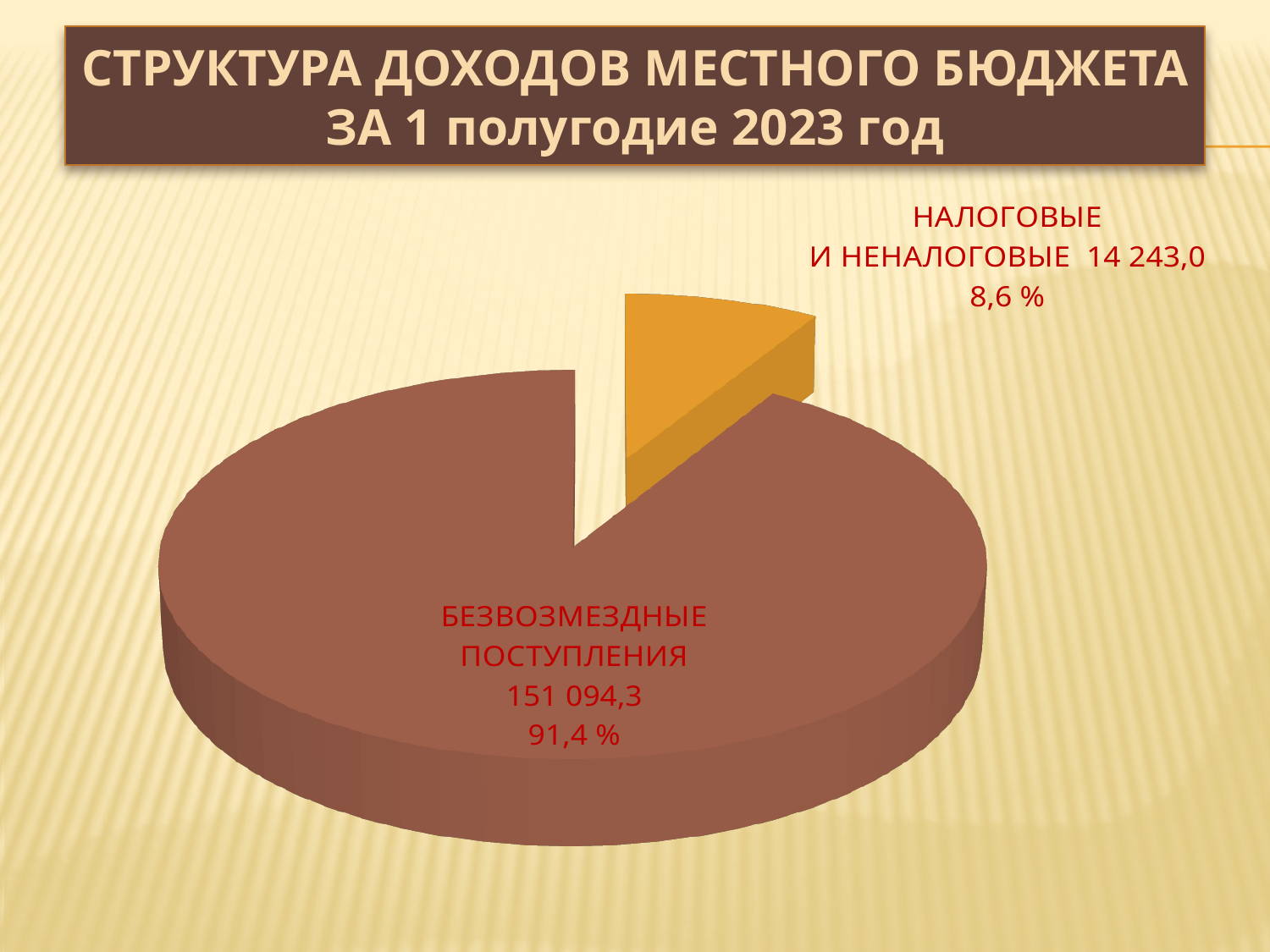
How many categories does the pie chart show? 2 Which category has the largest slice of the pie? БЕЗВОЗМЕЗДНЫЕ ПОСТУПЛЕНИЯ Which category has the smallest slice of the pie? НАЛОГОВЫЕ И НЕНАЛОГОВЫЕ What colour is the slice for НАЛОГОВЫЕ И НЕНАЛОГОВЫЕ? orange Which is larger, БЕЗВОЗМЕЗДНЫЕ ПОСТУПЛЕНИЯ or НАЛОГОВЫЕ И НЕНАЛОГОВЫЕ? БЕЗВОЗМЕЗДНЫЕ ПОСТУПЛЕНИЯ What share of the pie does БЕЗВОЗМЕЗДНЫЕ ПОСТУПЛЕНИЯ represent? 91,4 % What is the title of the slide containing the chart? СТРУКТУРА ДОХОДОВ МЕСТНОГО БЮДЖЕТА ЗА 1 полугодие 2023 год What share of the pie does НАЛОГОВЫЕ И НЕНАЛОГОВЫЕ represent? 8,6 % What is the value for БЕЗВОЗМЕЗДНЫЕ ПОСТУПЛЕНИЯ? 151 094,3 What is the difference in percentage share between БЕЗВОЗМЕЗДНЫЕ ПОСТУПЛЕНИЯ and НАЛОГОВЫЕ И НЕНАЛОГОВЫЕ? 82,8 % What is the value for НАЛОГОВЫЕ И НЕНАЛОГОВЫЕ? 14 243,0 What kind of chart is shown on the slide? pie chart